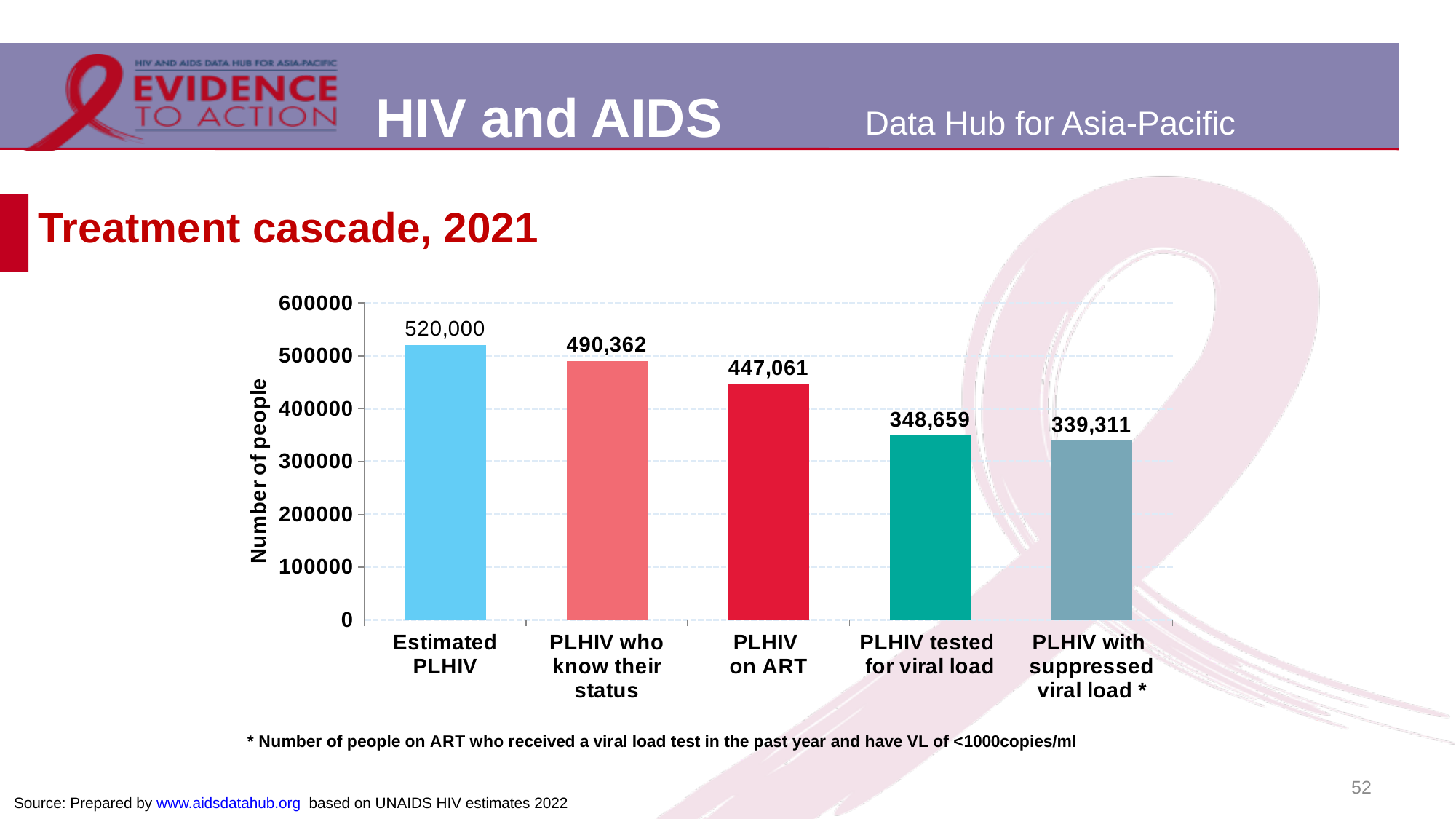
What kind of chart is shown on the slide? Bar chart How many categories are shown in the chart? 5 What is the value for Estimated PLHIV? 520,000 What is the value for PLHIV tested for viral load? 348,659 What is the value for PLHIV on ART? 447,061 Which category has the highest value? Estimated PLHIV Which category has the lowest value? PLHIV with suppressed viral load What is the value for PLHIV with suppressed viral load? 339,311 Do the values rise or fall from left to right across the categories? Fall What is the difference between Estimated PLHIV and PLHIV on ART? 72,939 What is the value for PLHIV who know their status? 490,362 Which is larger, PLHIV who know their status or PLHIV tested for viral load? PLHIV who know their status